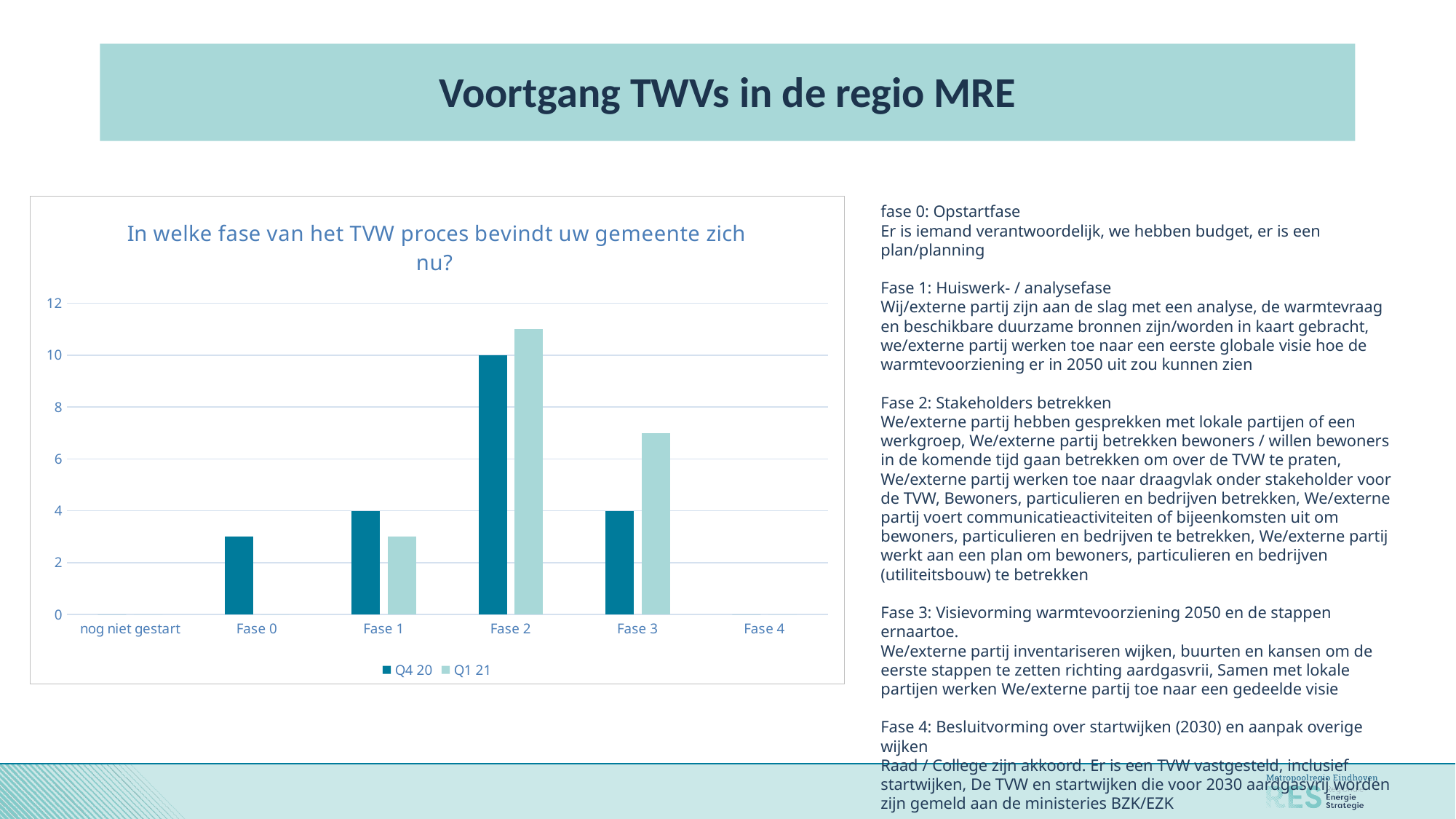
Is the value for Fase 2 in the Q1 21 series greater or less than 10? greater How many series does the chart legend list? 2 For Fase 3, which series has the larger value, Q4 20 or Q1 21? Q1 21 Which category has the highest value in the Q4 20 series? Fase 2 What is the value for Fase 1 in the Q4 20 series? 4 How many categories are shown on the x axis of the chart? 6 Which category has the highest value in the Q1 21 series? Fase 2 What is the value for Fase 2 in the Q4 20 series? 10 What is the title of the chart? In welke fase van het TVW proces bevindt uw gemeente zich nu? Is the value for Fase 3 in the Q1 21 series greater or less than 6? greater What kind of chart is shown on the slide? bar chart What is the value for Fase 3 in the Q4 20 series? 4